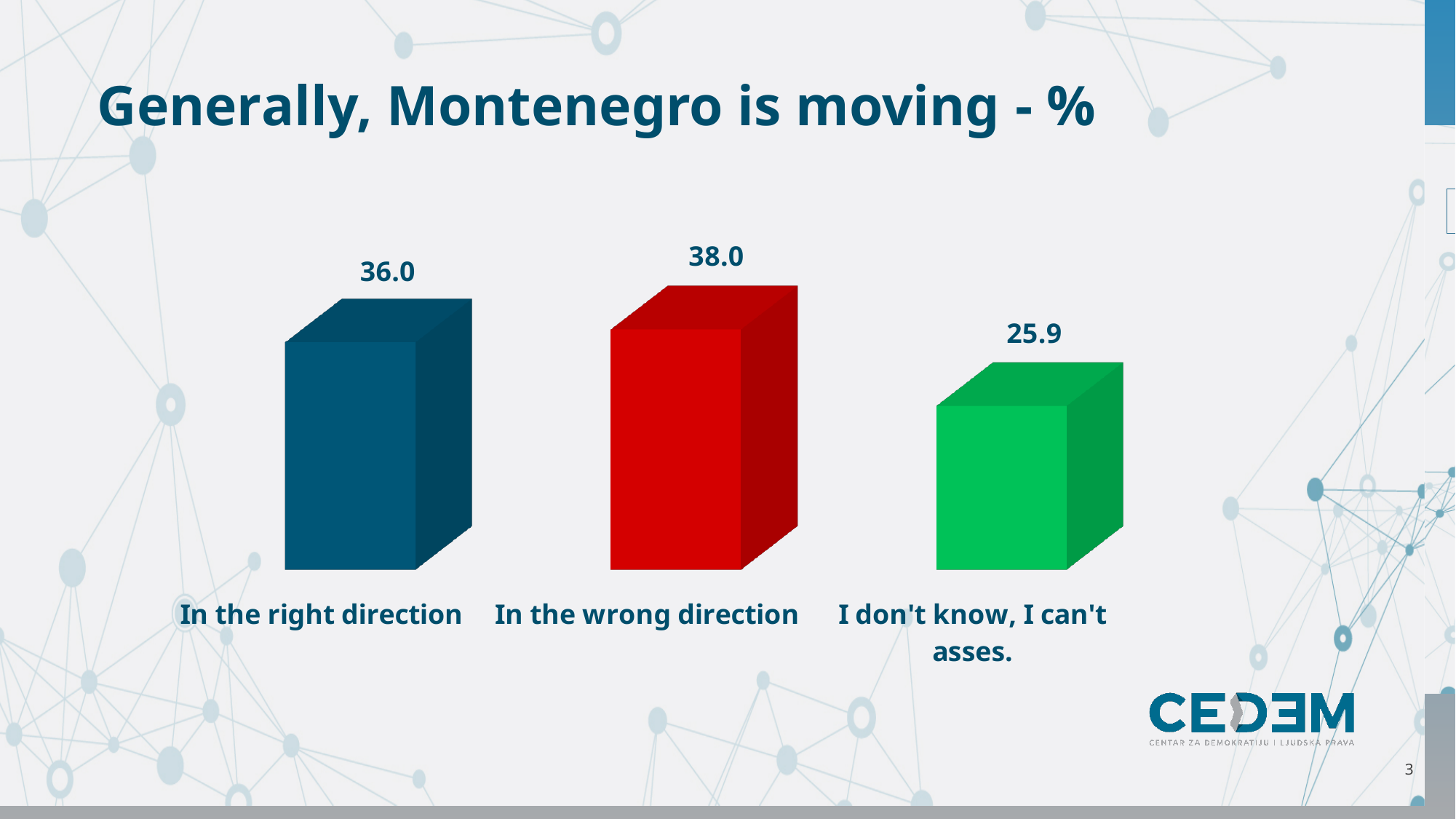
What is the title of the slide? Generally, Montenegro is moving - % Which category has the lowest value? I don't know, I can't asses. What colour is the bar for "In the wrong direction"? Red What kind of chart is shown on the slide? Bar chart What is the difference between the values for "In the wrong direction" and "In the right direction"? 2.0 What is the difference between the values for "In the right direction" and "I don't know, I can't asses."? 10.1 How many categories are shown in the chart? 3 What is the value for "In the right direction"? 36.0 What is the value for "In the wrong direction"? 38.0 Which is larger: the value for "In the right direction" or the value for "I don't know, I can't asses."? In the right direction What is the value for "I don't know, I can't asses."? 25.9 Which category has the highest value? In the wrong direction